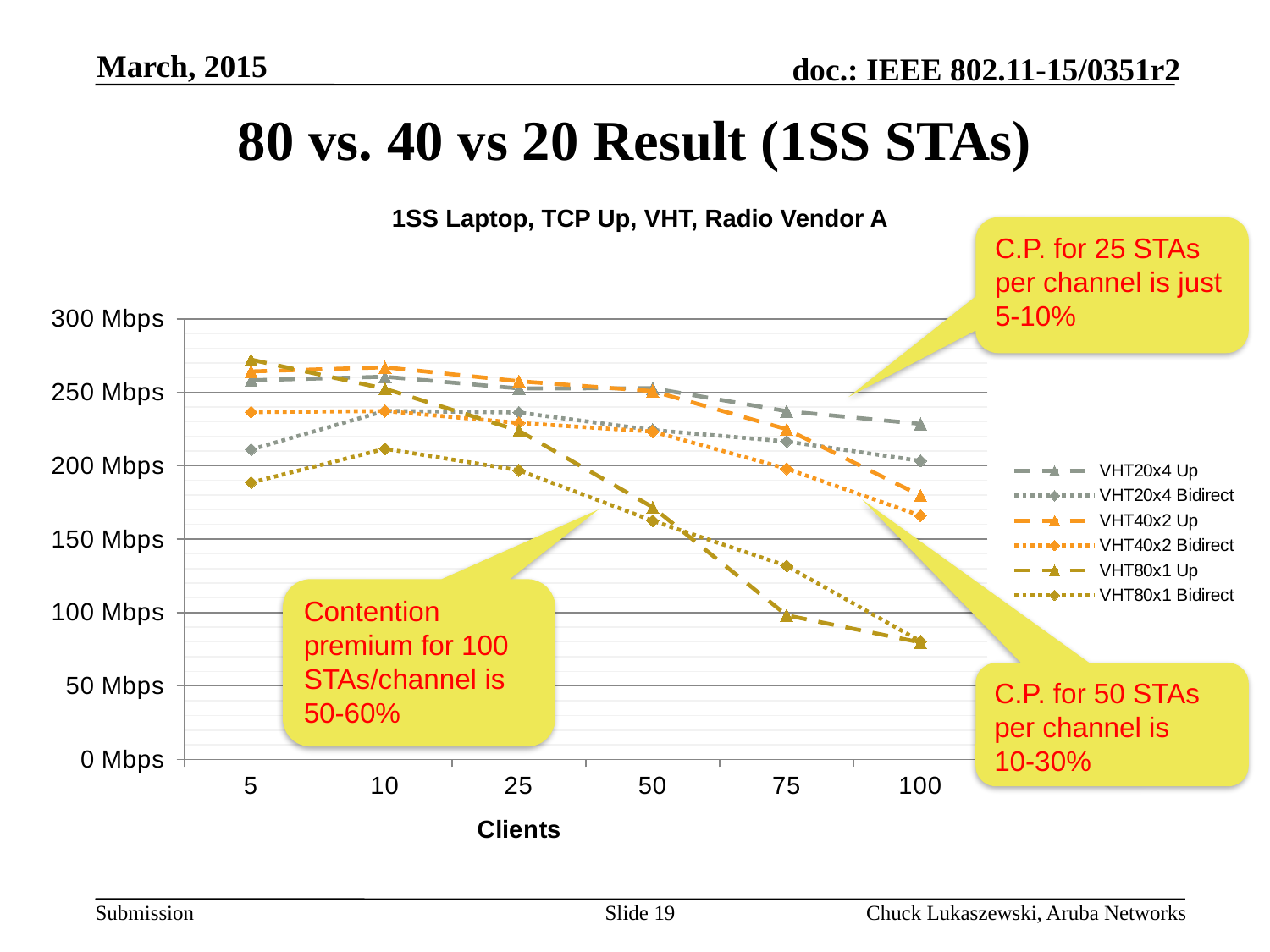
What is the label of the x axis? Clients What kind of chart is shown on the slide? line chart Does the VHT80x1 Up series rise or fall from 25 clients to 100 clients? fall Is the value for VHT80x1 Bidirect at 5 clients greater or less than 200 Mbps? less At 100 clients, which is larger: VHT20x4 Up or VHT80x1 Up? VHT20x4 Up Is the value for VHT80x1 Bidirect at 75 clients greater or less than 100 Mbps? greater How many client counts are plotted along the x axis? 6 What is the title of the chart? 1SS Laptop, TCP Up, VHT, Radio Vendor A Is the value for VHT20x4 Up at 100 clients greater or less than 200 Mbps? greater Which series has the lowest value at 5 clients? VHT80x1 Bidirect How many series does the legend list? 6